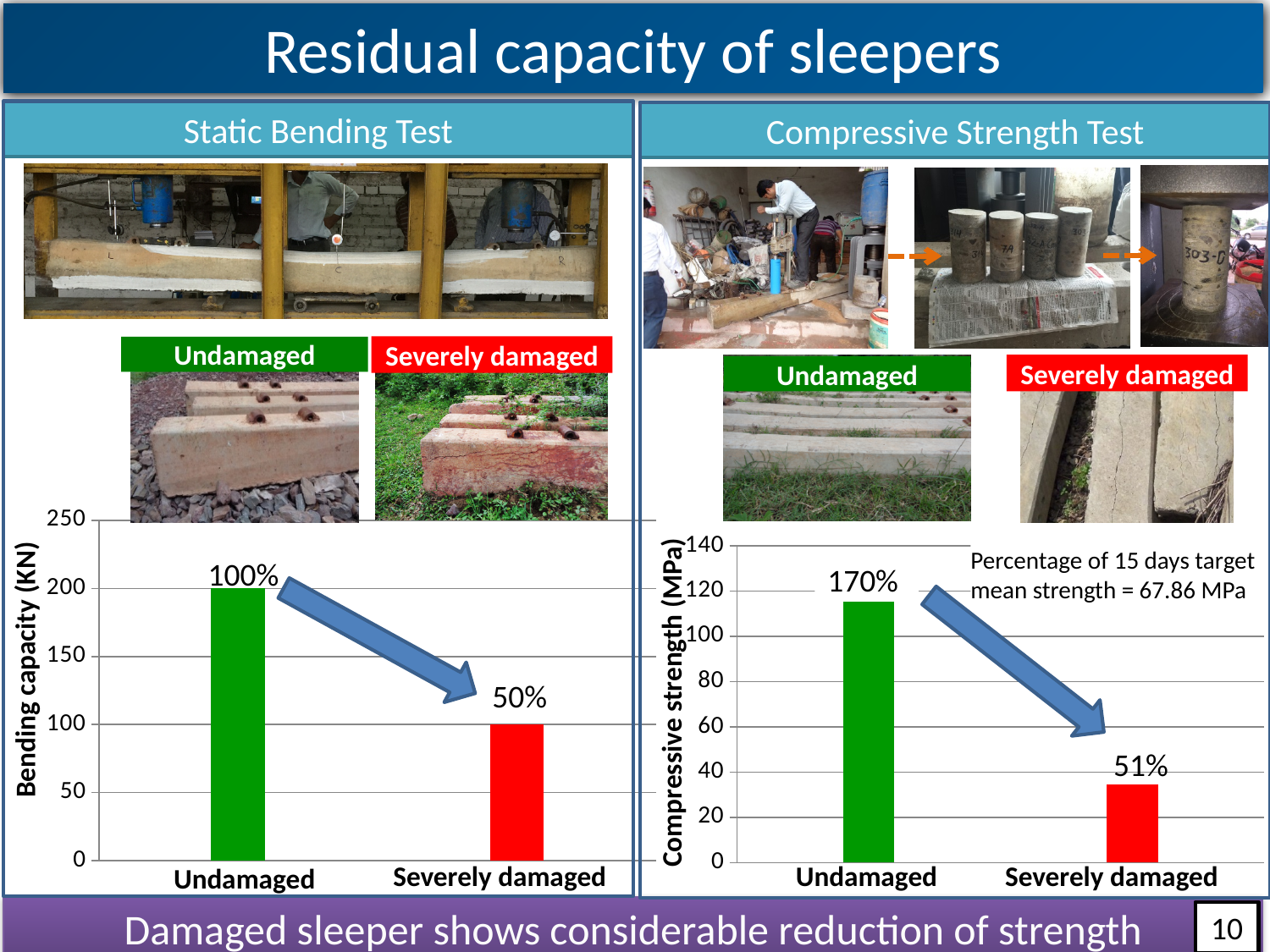
In the Static Bending Test chart, what is the difference in bending capacity (KN) between the Undamaged and Severely damaged bars? 100 In the Compressive Strength Test chart, is the compressive strength for Severely damaged greater or less than 40 MPa? less In the Static Bending Test chart, what bending capacity in KN does the Undamaged bar reach? 200 How many categories are plotted in the Static Bending Test chart? 2 In the Static Bending Test chart, what percentage label is shown above the Undamaged bar? 100% In the Compressive Strength Test chart, is the compressive strength for Undamaged greater or less than 100 MPa? greater In the Compressive Strength Test chart, what percentage label is shown above the Undamaged bar? 170% In the Static Bending Test chart, what percentage label is shown above the Severely damaged bar? 50% In the Compressive Strength Test chart, what percentage label is shown above the Severely damaged bar? 51% What type of chart is used in the Static Bending Test panel? bar chart In the Static Bending Test chart, what bending capacity in KN does the Severely damaged bar reach? 100 In the Compressive Strength Test chart, which category has the higher compressive strength? Undamaged